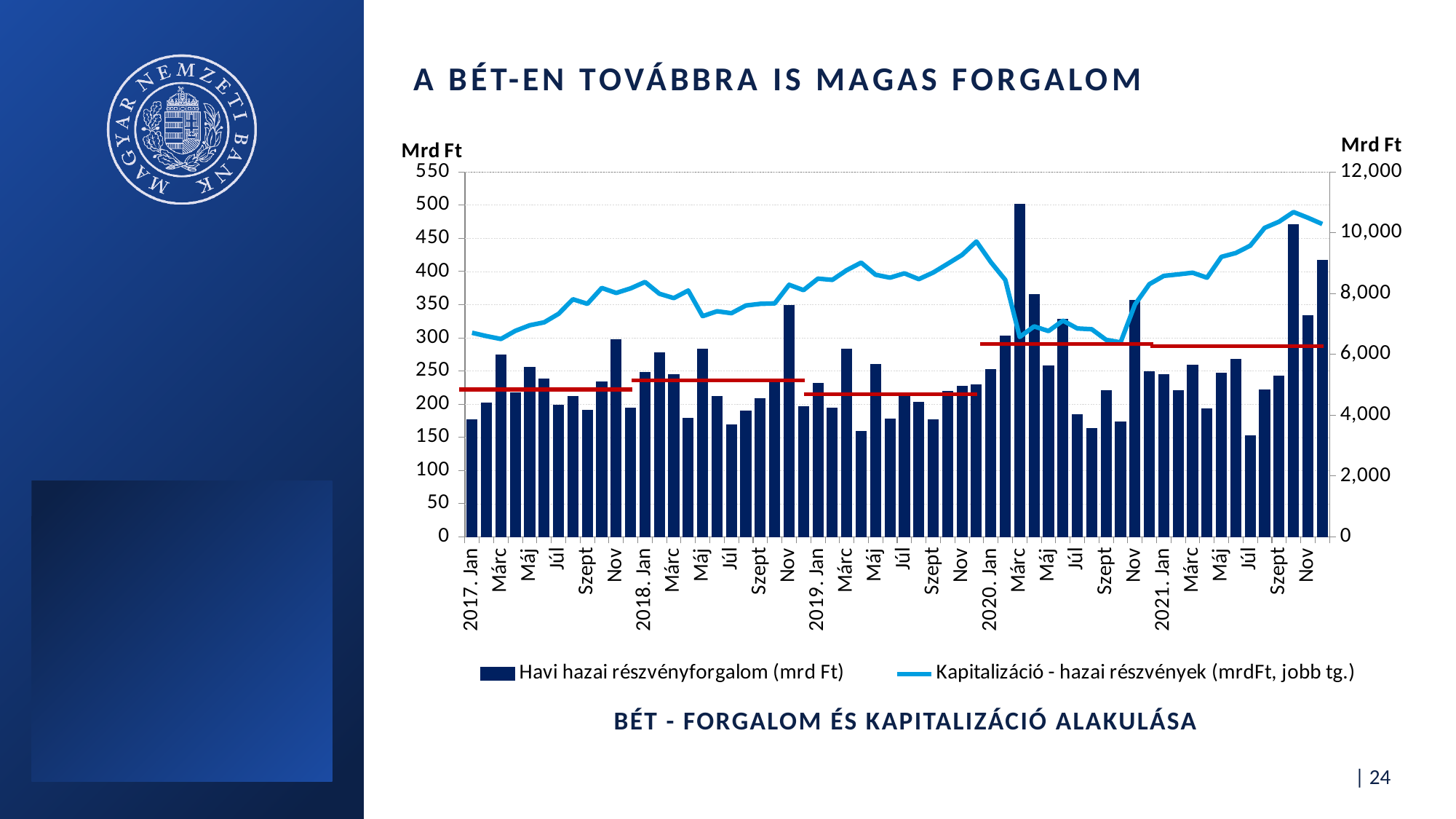
In which month is the bar for Havi hazai részvényforgalom the highest? 2020 Márc What is the title printed below the chart? BÉT - FORGALOM ÉS KAPITALIZÁCIÓ ALAKULÁSA What kind of chart is shown on the slide? A combination bar and line chart Which bar is taller, 2020 Márc or 2018 Nov? 2020 Márc How many series does the legend list? 2 Which series is plotted as a line? Kapitalizáció - hazai részvények (mrdFt, jobb tg.) Is the bar value for 2021 Nov greater or less than 400? less Is the bar value for 2020 Márc greater or less than 450? greater Is the Kapitalizáció line value for 2021 Nov greater or less than 8,000 on the right axis? greater Does the Kapitalizáció line generally rise or fall from 2017 Jan to 2019 Nov? rise